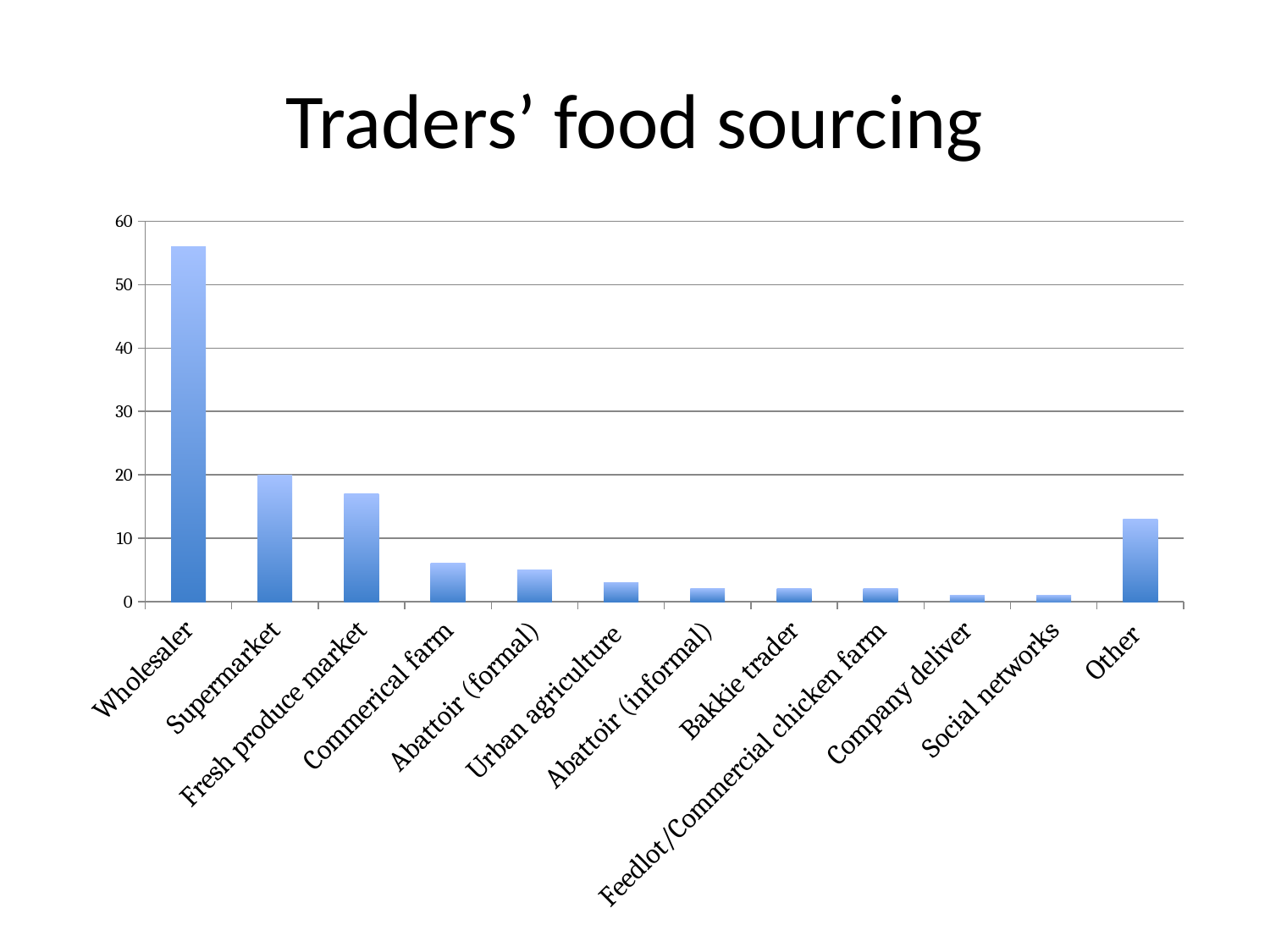
Is the value for Wholesaler greater or less than 50? greater Is the value for Fresh produce market greater or less than 20? less Which is larger, the value for Fresh produce market or the value for Other? Fresh produce market Which is larger, the value for Other or the value for Commerical farm? Other Is the value for Other greater or less than 10? greater What is the title of the chart? Traders' food sourcing How many categories are shown on the x axis of the chart? 12 What kind of chart is shown on the slide? bar chart Which category has the highest value in the chart? Wholesaler Which is larger, the value for Wholesaler or the value for Supermarket? Wholesaler